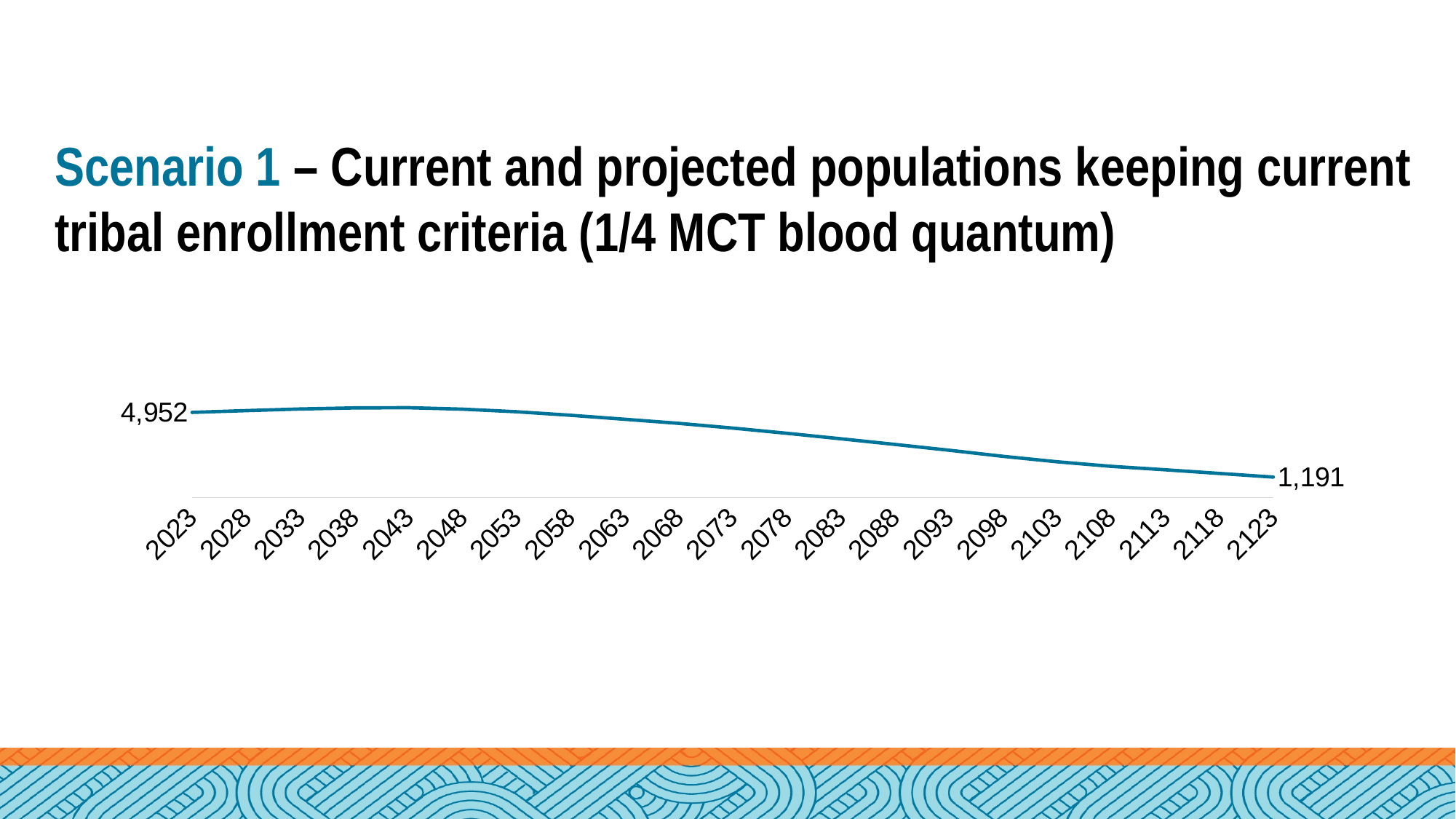
What is the difference between the value for 2023 and the value for 2123? 3,761 Do the values rise or fall overall from 2023 to 2123? Fall What is the interval between consecutive years on the x axis? 5 years How many years are labelled along the x axis? 21 What is the value shown for 2023? 4,952 What is the value shown for 2123? 1,191 What kind of chart is shown on the slide? Line chart What is the first year shown on the x axis? 2023 Which is larger, the value for 2023 or the value for 2123? 2023 Which year on the x axis has the lowest value? 2123